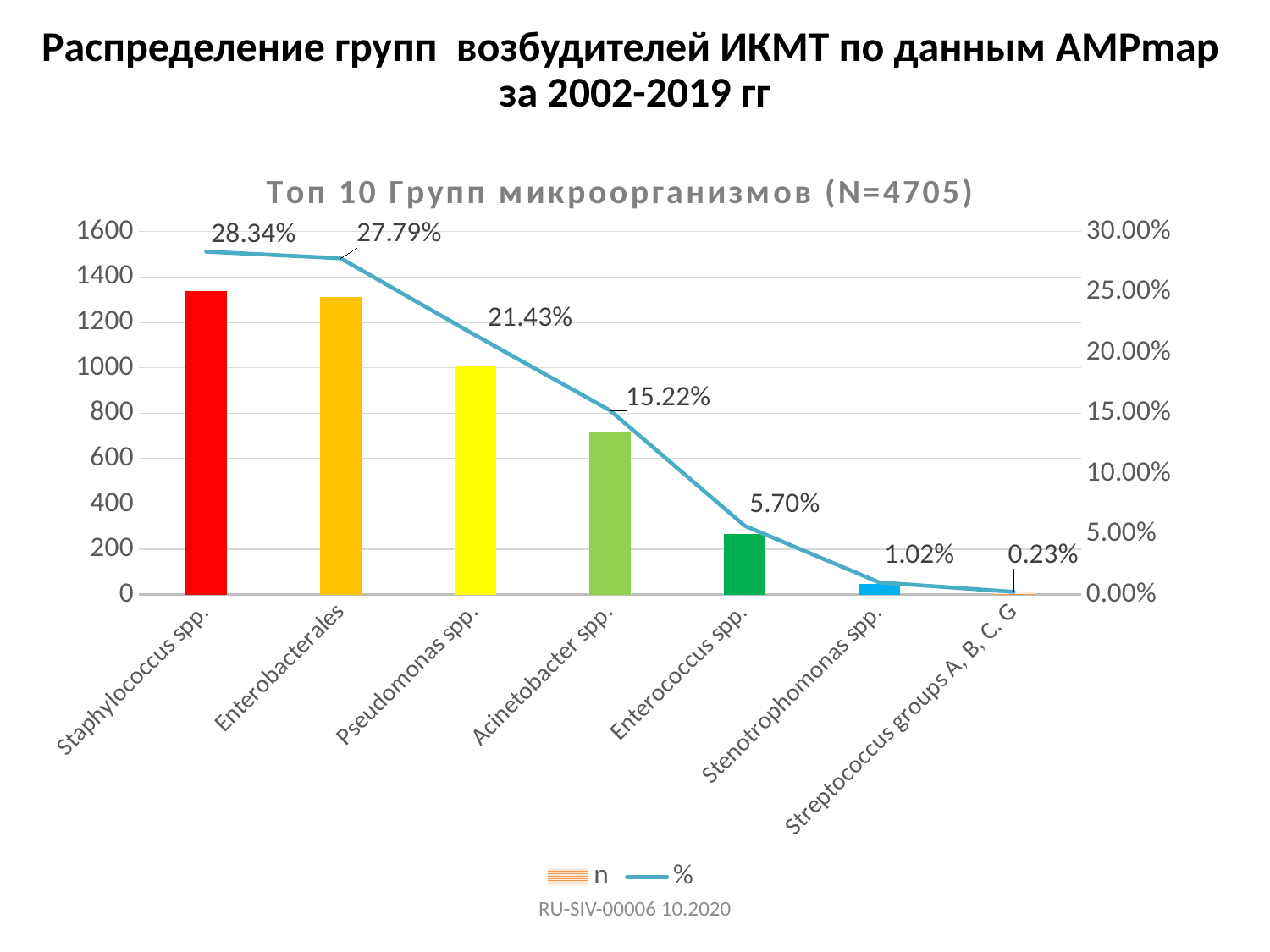
How many microorganism groups are shown on the x axis? 7 What percentage is shown for Acinetobacter spp. on the % line? 15.22% What is the difference between the % values for Pseudomonas spp. and Enterococcus spp.? 15.73% What percentage is shown for Stenotrophomonas spp. on the % line? 1.02% Is the n value for Enterococcus spp. greater or less than 400? less Do the % values rise or fall from left to right along the x axis? fall Is the n value for Staphylococcus spp. greater or less than 1200? greater What percentage is shown for Staphylococcus spp. on the % line? 28.34% How many series does the legend list? 2 Which category has the lowest value on the % line? Streptococcus groups A, B, C, G Which has a larger n bar, Pseudomonas spp. or Acinetobacter spp.? Pseudomonas spp. Which category has the highest value on the % line? Staphylococcus spp.